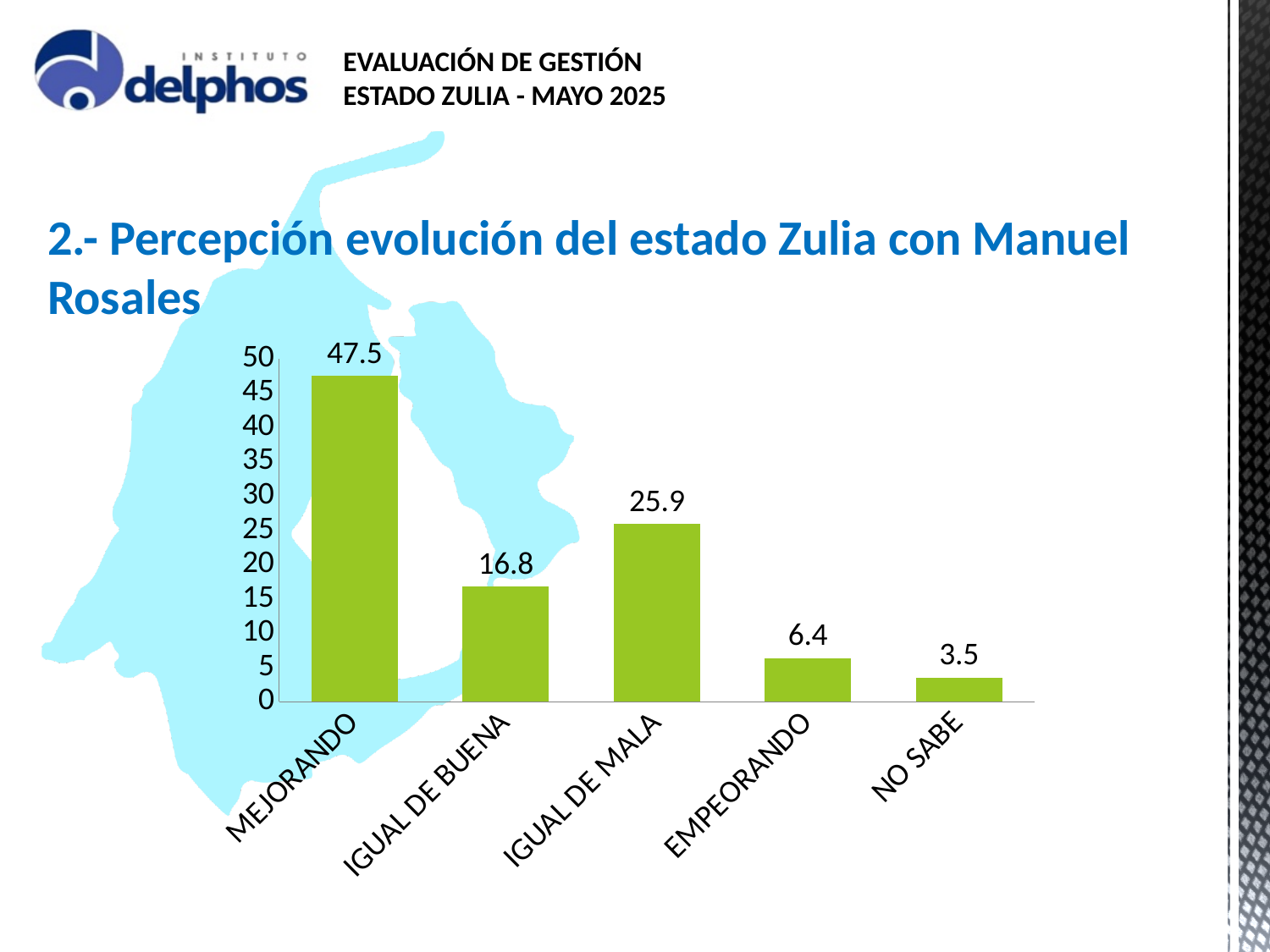
What is the value for IGUAL DE MALA? 25.9 What kind of chart is shown on the slide? bar chart Which category has the lowest value? NO SABE How many categories are shown on the x axis? 5 Which category has the highest value? MEJORANDO What is the value for MEJORANDO? 47.5 What is the value for NO SABE? 3.5 Is the value for EMPEORANDO greater or less than 10? less What is the value for IGUAL DE BUENA? 16.8 Which is larger, the value for IGUAL DE BUENA or the value for IGUAL DE MALA? IGUAL DE MALA What is the difference between the values for MEJORANDO and IGUAL DE MALA? 21.6 What is the value for EMPEORANDO? 6.4